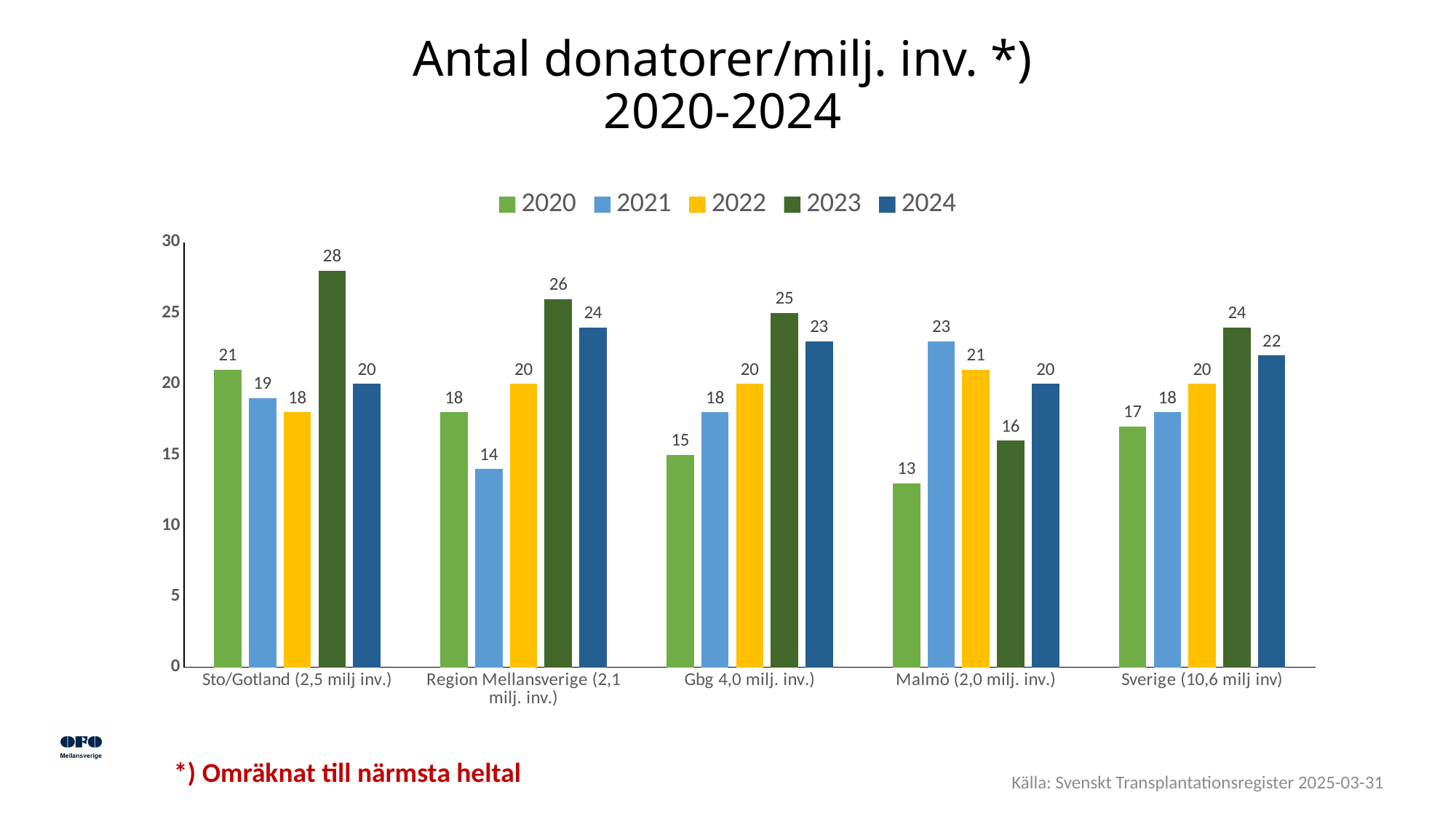
What is the title of the chart? Antal donatorer/milj. inv. *) 2020-2024 Is the value for Gbg 4,0 milj. inv. in 2020 greater or less than 20? less What is the value for Sverige (10,6 milj inv) in 2024? 22 What kind of chart is shown on the slide? bar chart What is the value for Malmö (2,0 milj. inv.) in 2020? 13 How many series does the legend list? 5 Which is larger for Malmö (2,0 milj. inv.): the 2021 value or the 2023 value? 2021 Which category has the highest value in the 2023 series? Sto/Gotland (2,5 milj inv.) What is the difference between the 2023 and 2024 values for Region Mellansverige (2,1 milj. inv.)? 2 How many categories are shown on the x axis? 5 Which category has the lowest value in the 2021 series? Region Mellansverige (2,1 milj. inv.) What is the value for Sto/Gotland (2,5 milj inv.) in 2023? 28